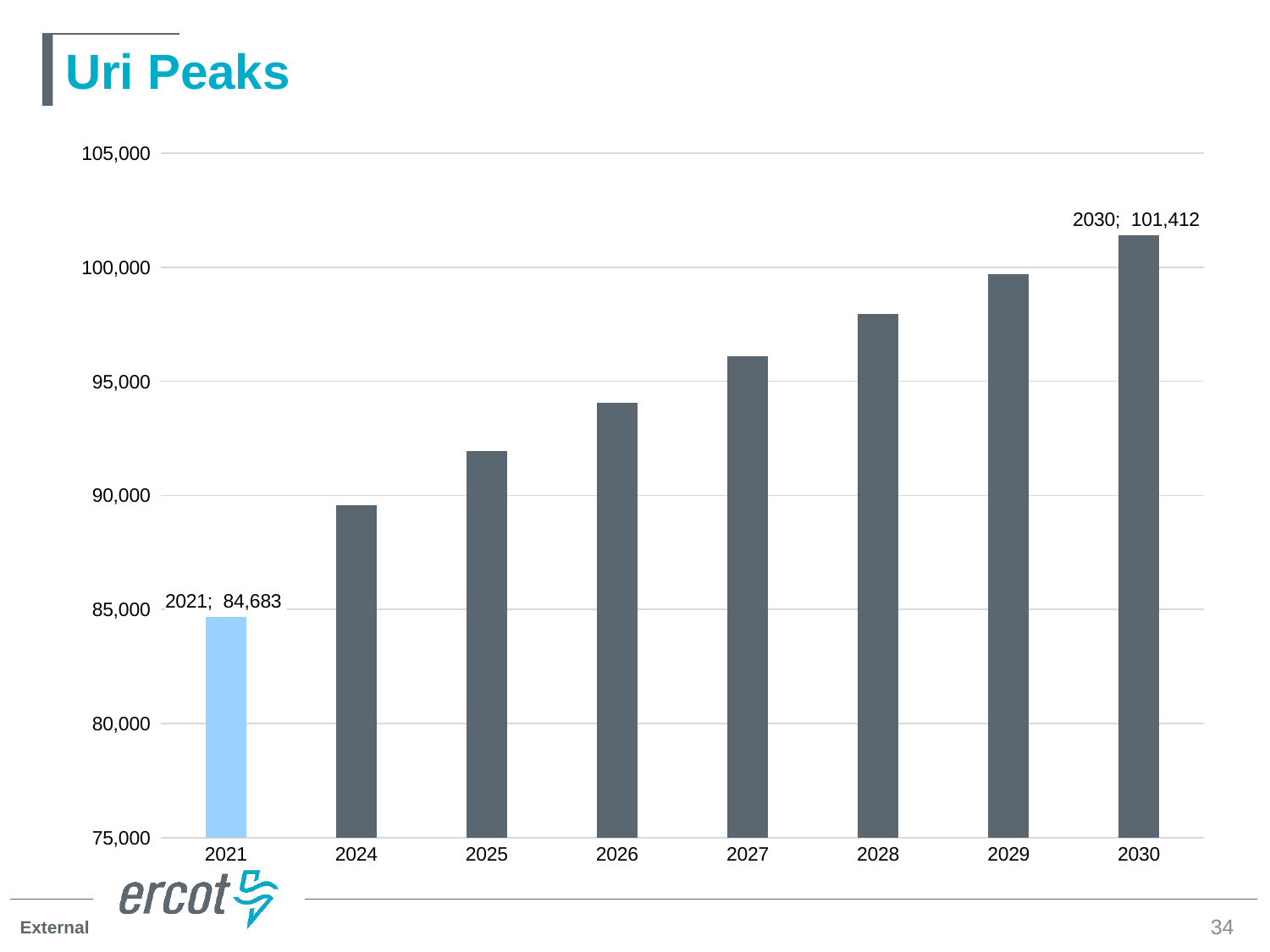
How many years are shown on the x axis? 8 Which is larger, the value for 2026 or the value for 2028? 2028 What is the difference between the values for 2030 and 2021? 16,729 Is the value for 2027 greater or less than 95,000? greater What kind of chart is shown on the slide? bar chart Do the values rise or fall from 2021 to 2030? rise Is the value for 2024 greater or less than 90,000? less Which year has the lowest value? 2021 Which year has the highest value? 2030 What is the value for 2021? 84,683 What is the value for 2030? 101,412